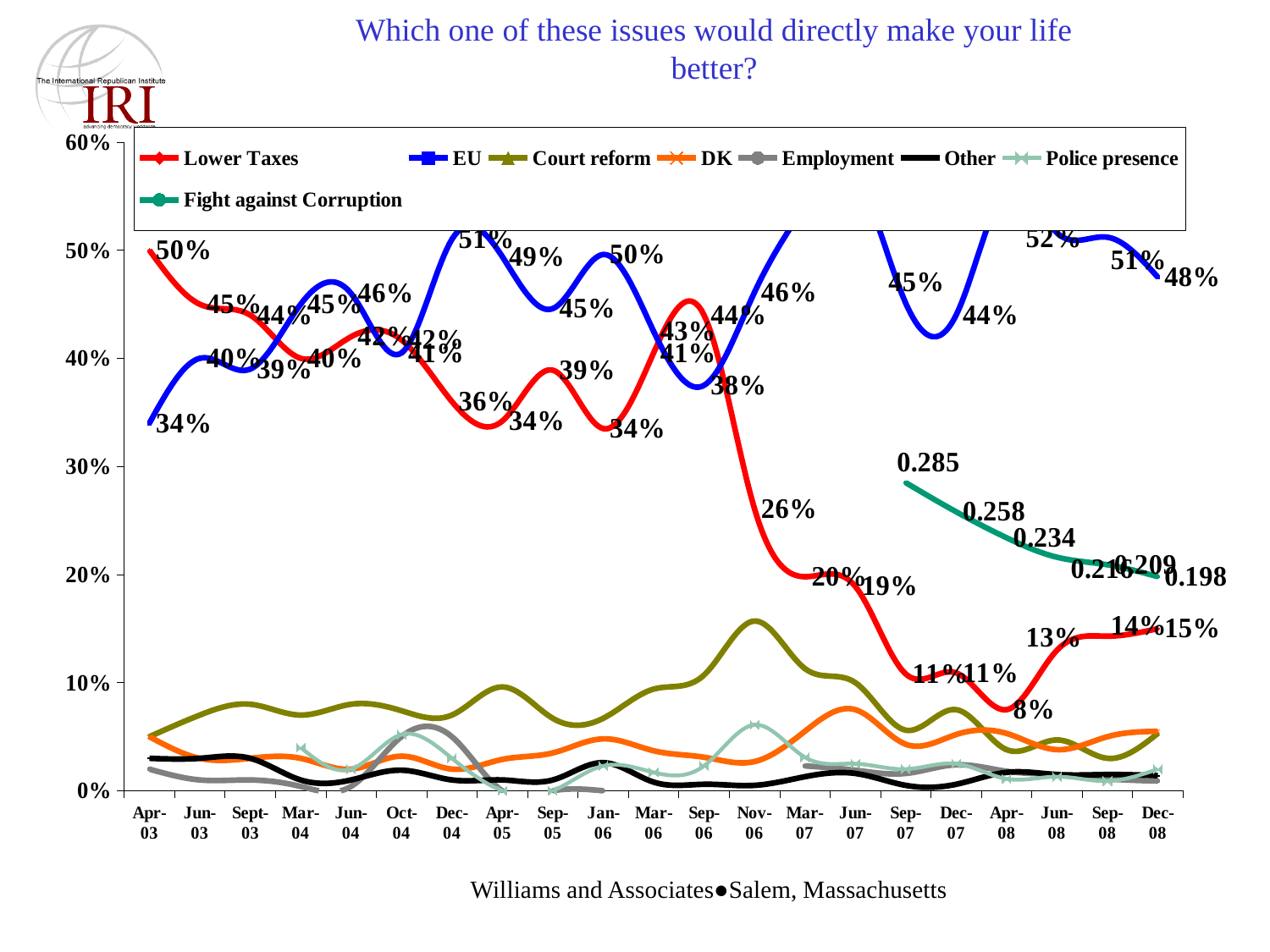
What is the value for Fight against Corruption in Sep-07? 0.285 What is the value for EU in Dec-08? 48% What kind of chart is shown on the slide? Line chart What is the value for Lower Taxes in Apr-03? 50% In Dec-08, which is larger: the EU value or the Lower Taxes value? EU At which date is the Lower Taxes series at its lowest? Apr-08 How many dates are shown along the x axis? 21 Does the Fight against Corruption series rise or fall from Sep-07 to Dec-08? Fall How many series does the legend list? 8 Is the value for Court reform in Nov-06 greater or less than 10%? greater What is the difference between the Lower Taxes value in Apr-03 and in Dec-08? 35 percentage points What is the value for Lower Taxes in Nov-06? 26%